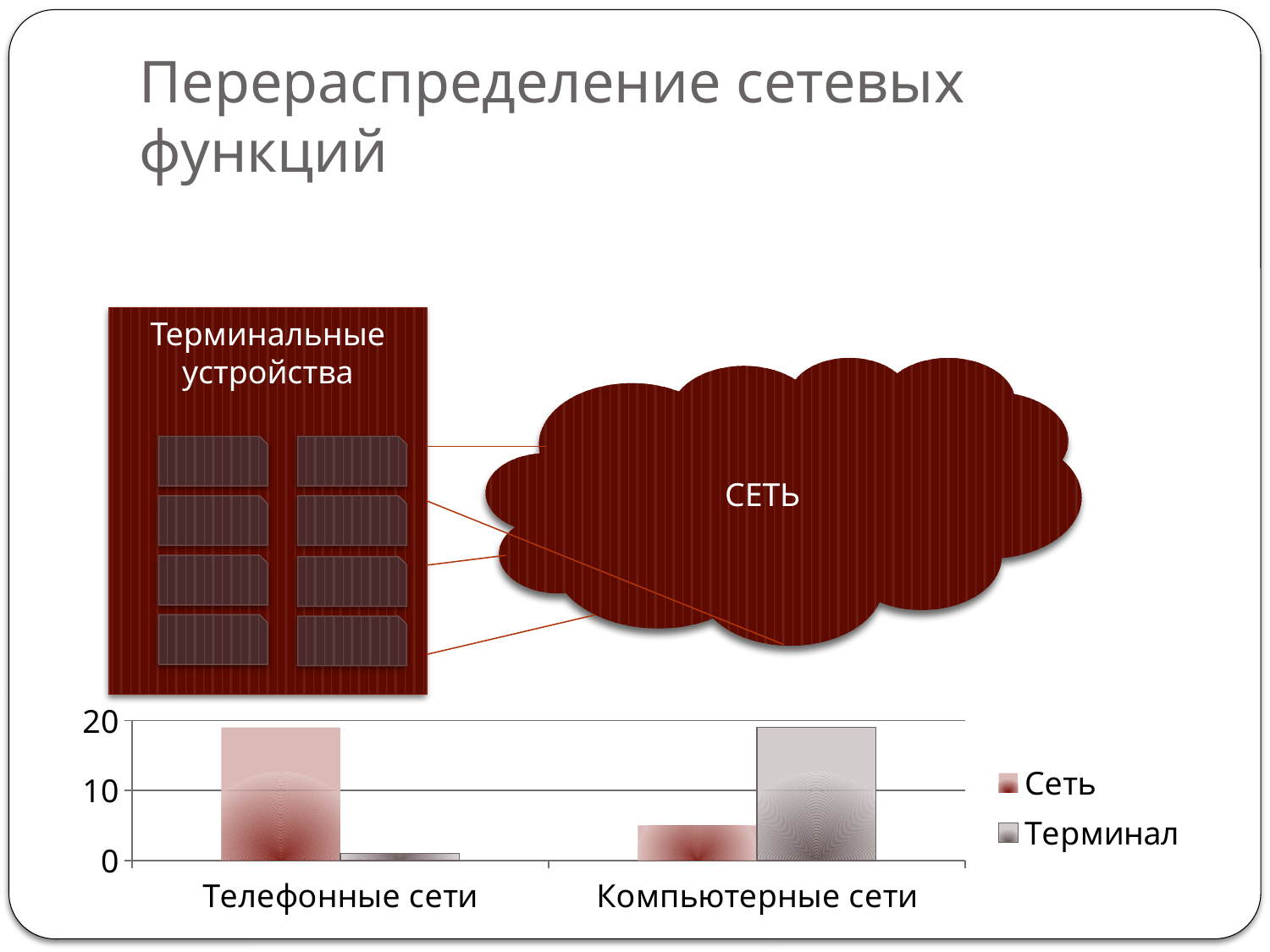
For which category is the Сеть series highest? Телефонные сети Is the value of Сеть for Компьютерные сети greater or less than 10? less For which category is the Терминал series lowest? Телефонные сети Which series is larger for Телефонные сети, Сеть or Терминал? Сеть Is the value of Терминал for Телефонные сети greater or less than 10? less What kind of chart is shown at the bottom of the slide? bar chart Is the value of Терминал for Компьютерные сети greater or less than 10? greater What are the two series names listed in the chart legend? Сеть and Терминал How many series does the chart legend list? 2 How many categories are shown on the x axis of the chart? 2 Which series is larger for Компьютерные сети, Сеть or Терминал? Терминал